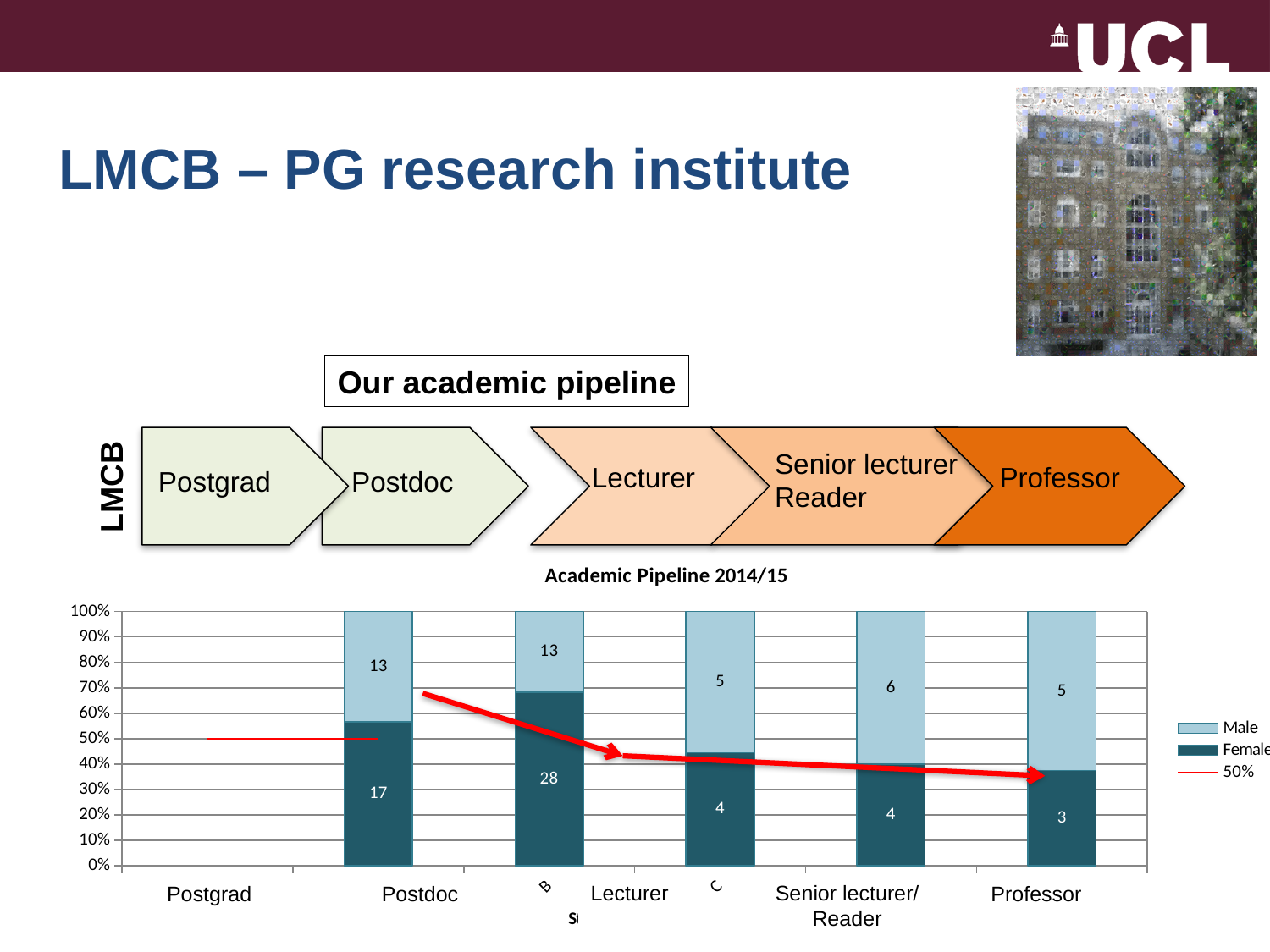
In the Academic Pipeline 2014/15 chart, which category has the highest female count? Postdoc In the Academic Pipeline 2014/15 chart, is the male count or the female count larger for Senior lecturer/Reader? Male How many categories are shown on the x axis of the Academic Pipeline 2014/15 chart? 5 How many entries does the legend of the Academic Pipeline 2014/15 chart list? 3 In the Academic Pipeline 2014/15 chart, how many female staff are shown for Postdoc? 28 In the Academic Pipeline 2014/15 chart, is the female share of the Postgrad bar greater or less than 50%? greater In the Academic Pipeline 2014/15 chart, how many female staff are shown for Lecturer? 4 In the Academic Pipeline 2014/15 chart, which category has the lowest female count? Professor What type of chart is shown under the title 'Academic Pipeline 2014/15'? Stacked bar chart In the Academic Pipeline 2014/15 chart, what is the total number of staff (male plus female) for Postgrad? 30 In the Academic Pipeline 2014/15 chart, how many male staff are shown for Professor? 5 In the Academic Pipeline 2014/15 chart, what is the difference between the female and male counts for Postdoc? 15